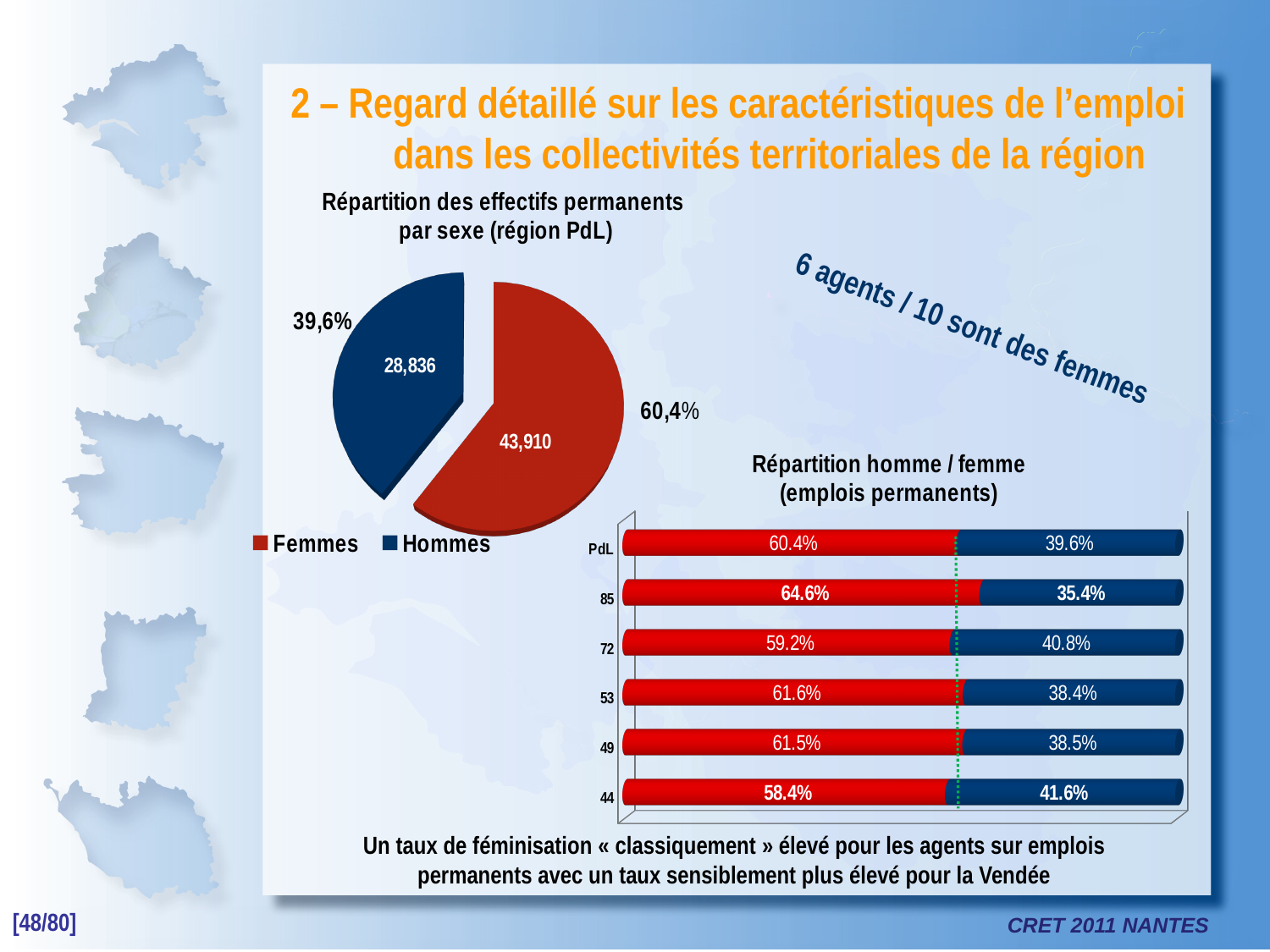
In the pie chart 'Répartition des effectifs permanents par sexe (région PdL)', which category has the larger slice? Femmes In the bar chart 'Répartition homme / femme (emplois permanents)', which category has the lowest red (women) share? 44 In the bar chart 'Répartition homme / femme (emplois permanents)', what is the blue (men) value for category 44? 41.6% In the pie chart 'Répartition des effectifs permanents par sexe (région PdL)', how many categories does the legend list? 2 In the bar chart 'Répartition homme / femme (emplois permanents)', how many categories are plotted? 6 In the bar chart 'Répartition homme / femme (emplois permanents)', what is the red (women) value for category 85? 64.6% In the pie chart 'Répartition des effectifs permanents par sexe (région PdL)', what value is shown for Hommes? 28,836 In the pie chart 'Répartition des effectifs permanents par sexe (région PdL)', what value is shown for Femmes? 43,910 In the pie chart 'Répartition des effectifs permanents par sexe (région PdL)', what percentage share do Femmes represent? 60,4% In the bar chart 'Répartition homme / femme (emplois permanents)', what is the difference between the red (women) values for category 85 and category 72? 5.4% In the bar chart 'Répartition homme / femme (emplois permanents)', which category has the highest red (women) share? 85 What kind of chart is 'Répartition homme / femme (emplois permanents)'? Stacked bar chart